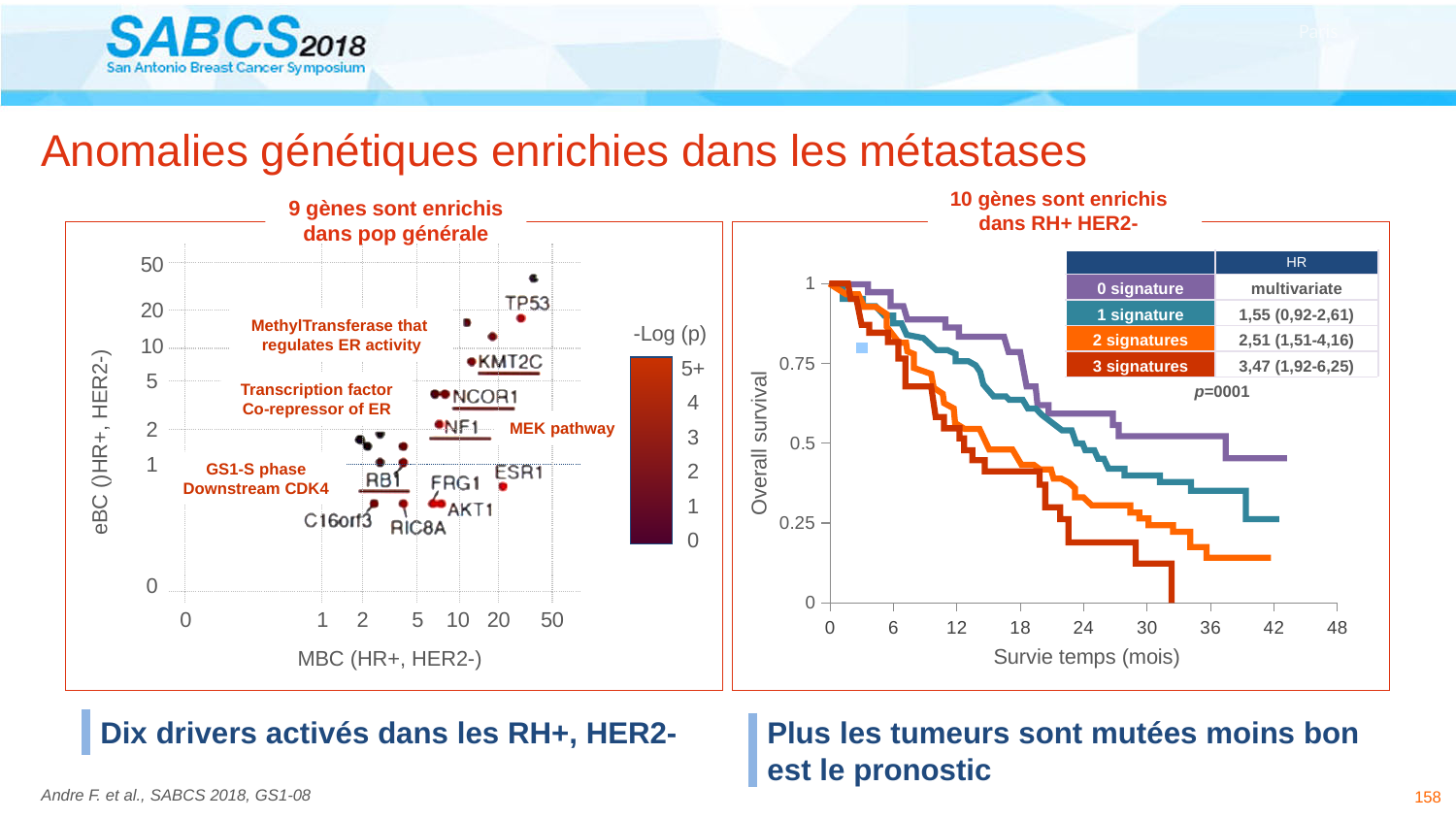
On the right chart, what is the multivariate HR shown for the '3 signatures' group? 3,47 (1,92-6,25) What kind of chart is the left chart titled '9 gènes sont enrichis dans pop générale'? scatter plot On the right chart, what is the multivariate HR shown for the '2 signatures' group? 2,51 (1,51-4,16) On the right chart (survival curves), how many groups does the legend list? 4 On the right chart, which signature group has the highest multivariate HR? 3 signatures On the right chart, is the overall survival of the '0 signature' group at 24 months greater or less than 0.5? greater On the right chart, which group has higher overall survival at 36 months: '0 signature' or '3 signatures'? 0 signature On the right chart, is the overall survival of the '3 signatures' group at 24 months greater or less than 0.5? less On the right chart, what p-value is printed below the HR table? p=0001 On the right chart, what is the multivariate HR shown for the '1 signature' group? 1,55 (0,92-2,61) On the right chart, what is the label of the x axis? Survie temps (mois) On the right chart, do the survival curves rise or fall as time (months) increases? fall